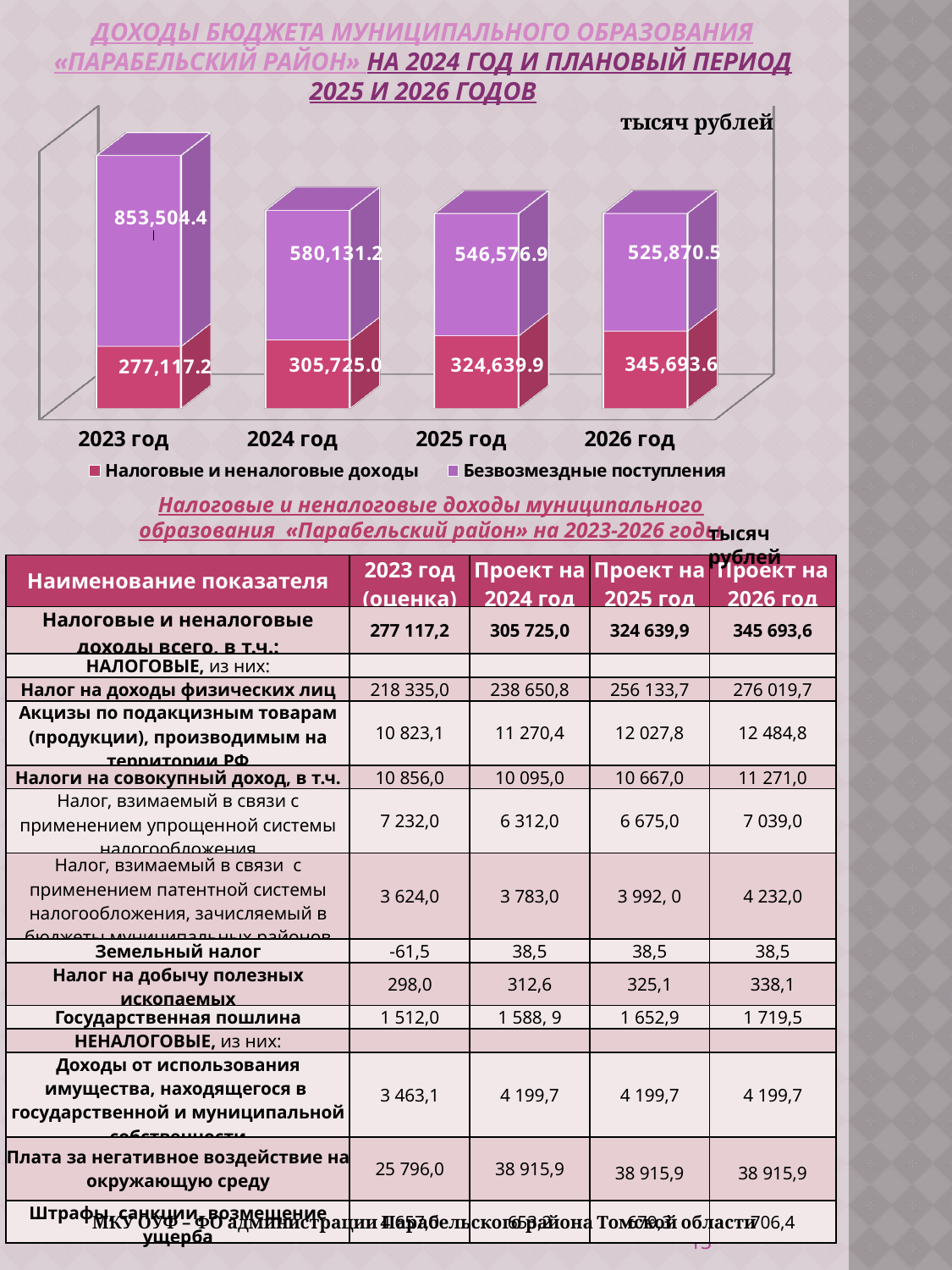
What is the value of «Безвозмездные поступления» for 2023 год? 853,504.4 Which is larger: «Налоговые и неналоговые доходы» in 2024 год or in 2025 год? 2025 год What is the value of «Безвозмездные поступления» for 2025 год? 546,576.9 By how much does «Безвозмездные поступления» in 2023 год exceed that in 2024 год? 273,373.2 What type of chart is shown on the slide? bar chart What is the value of «Налоговые и неналоговые доходы» for 2026 год? 345,693.6 What is the total of the stacked bar for 2024 год? 885,856.2 In which year is «Безвозмездные поступления» highest? 2023 год How many year categories are shown on the chart's x axis? 4 How many series does the chart legend list? 2 In which year is «Налоговые и неналоговые доходы» lowest? 2023 год Does «Налоговые и неналоговые доходы» rise or fall from 2023 год to 2026 год? rises